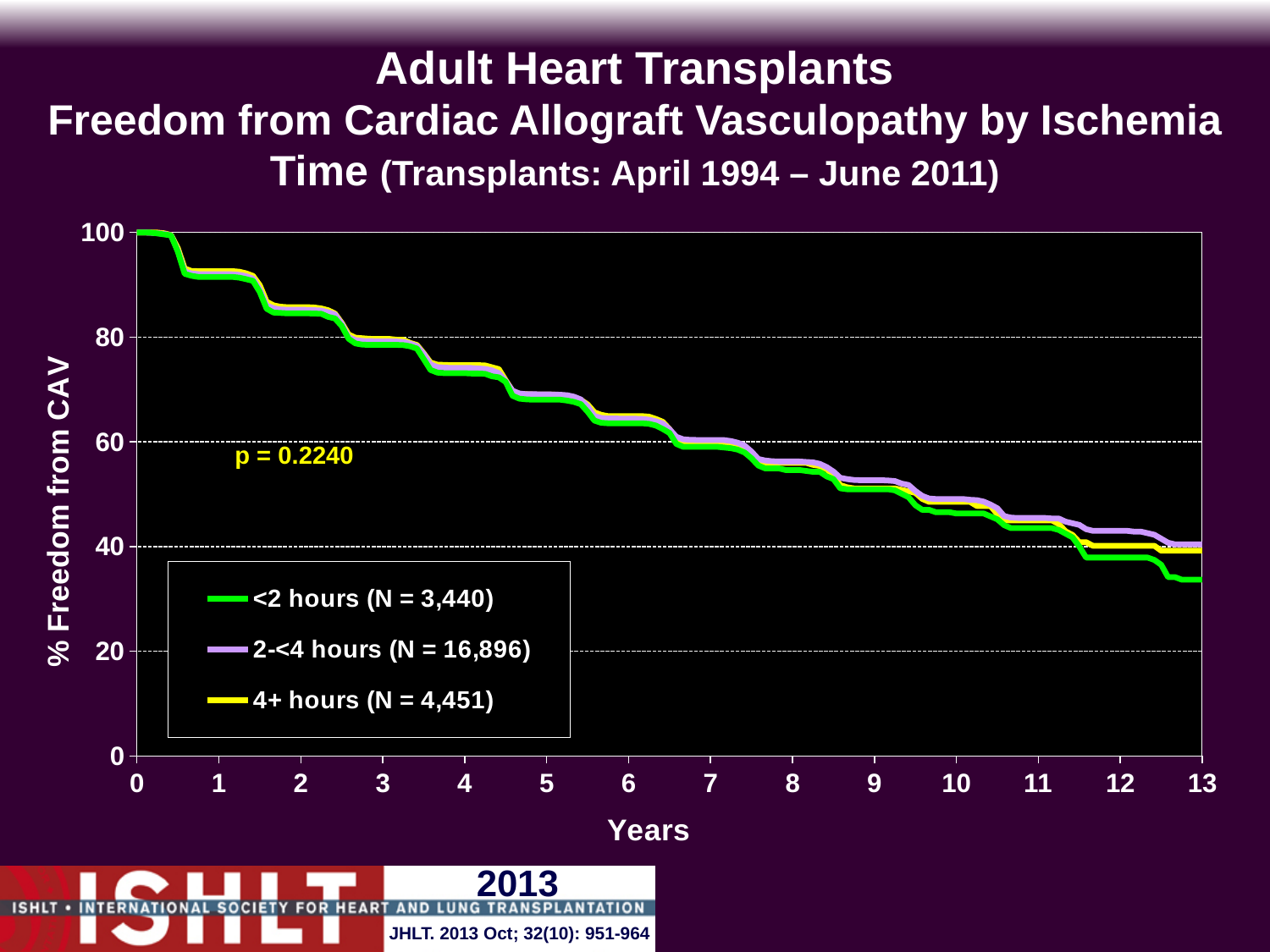
What is the maximum value shown on the x axis (Years)? 13 What is the % Freedom from CAV for all three groups at year 0? 100 Is the value for the <2 hours group at year 13 greater or less than 40? less At year 13, which group has the higher % Freedom from CAV, <2 hours or 2-<4 hours? 2-<4 hours Is the value for the 4+ hours group at year 10 greater or less than 60? less Is the value for the 2-<4 hours group at year 5 greater or less than 60? greater How many series does the legend list? 3 What kind of chart is shown on the slide? line chart Do the values for % Freedom from CAV rise or fall as Years increase? fall What p-value is printed on the chart? p = 0.2240 What is the N for the 2-<4 hours group shown in the legend? 16,896